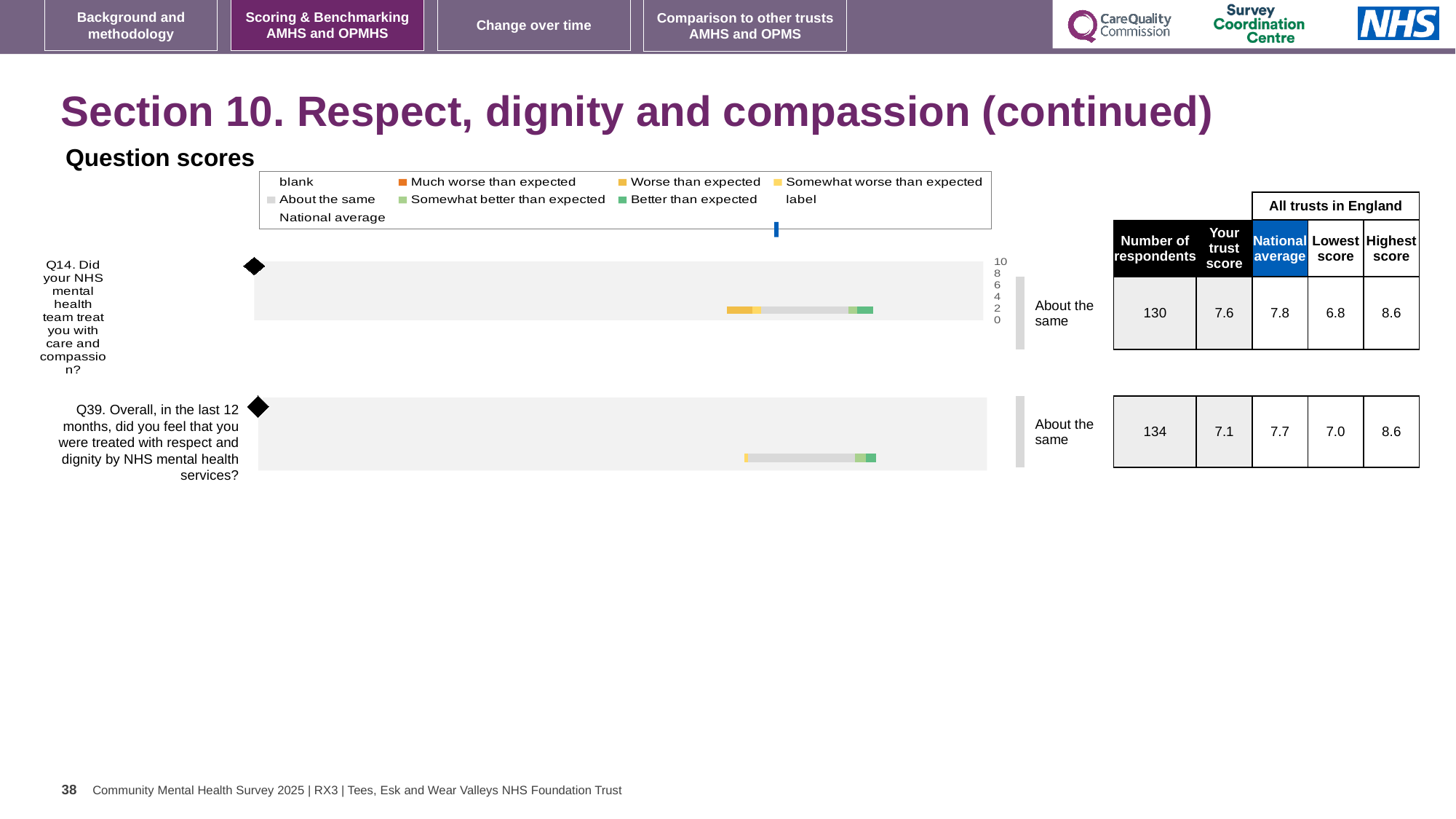
What is the difference between the highest score and the lowest score for Q14? 1.8 Which question has the higher trust score, Q14 or Q39? Q14 How many questions are plotted in the question scores chart? 2 What is the trust score for Q39 (treated with respect and dignity)? 7.1 What kind of chart is used to show the question scores on this slide? bar chart What is the trust score for Q14 (care and compassion)? 7.6 What is the difference between the national average and the trust score for Q39? 0.6 What is the lowest score among all trusts in England for Q39? 7.0 Which legend entry is shown in orange in the question scores chart? Much worse than expected What is the national average for Q14? 7.8 What benchmark category is shown next to the chart for Q14? About the same How many respondents answered Q39? 134